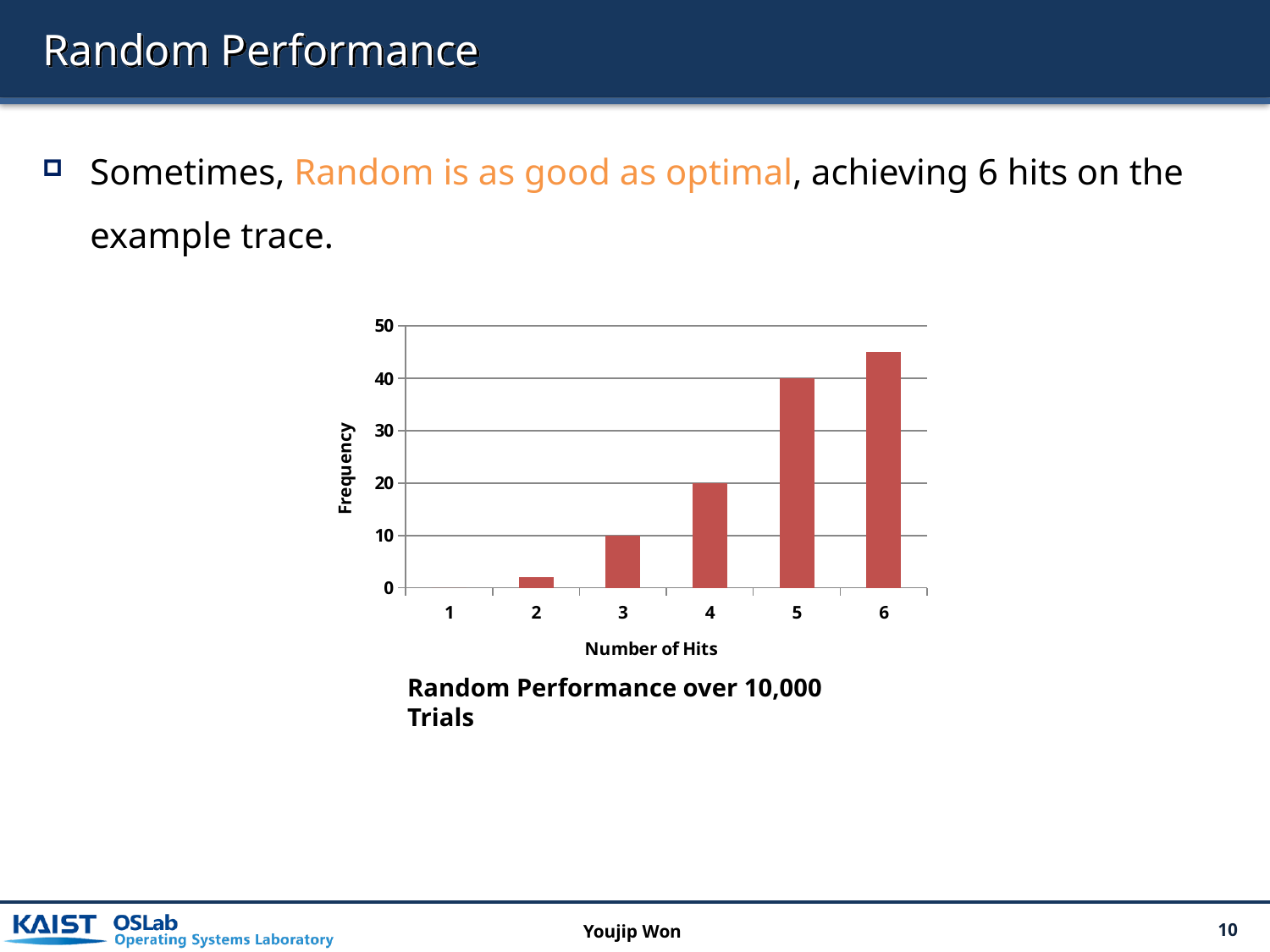
What is the frequency for 4 hits? 20 What is the frequency for 5 hits? 40 Is the frequency for 2 hits greater or less than 10? less What is the difference in frequency between 5 hits and 4 hits? 20 Which number of hits has the highest frequency? 6 Which number of hits has the lowest frequency? 1 Is the frequency for 6 hits greater or less than 40? greater Do the frequencies rise or fall as the number of hits increases from 1 to 6? Rise What kind of chart is shown on the slide? Bar chart How many categories are shown on the x axis of the chart? 6 What is the frequency for 3 hits? 10 What is the label of the x axis of the chart? Number of Hits